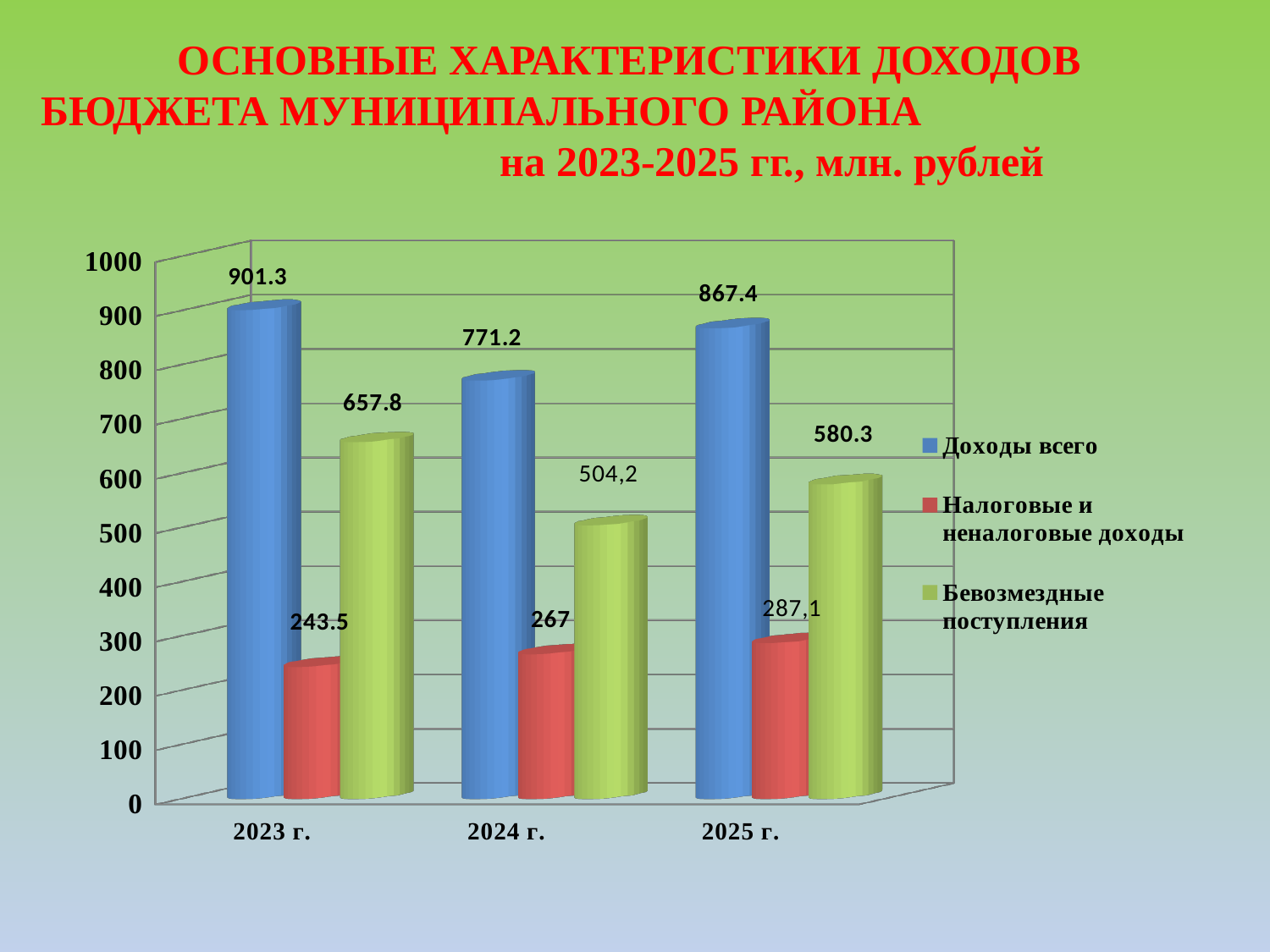
What is the value of Безвозмездные поступления for 2024 г.? 504,2 What is the difference between Доходы всего in 2023 г. and in 2024 г.? 130.1 What is the value of Налоговые и неналоговые доходы for 2025 г.? 287,1 In which year is Доходы всего the highest? 2023 г. In which year is Налоговые и неналоговые доходы the lowest? 2023 г. How many years are shown on the x axis? 3 What kind of chart is shown on the slide? Bar chart What is the value of Доходы всего for 2023 г.? 901.3 Do the values of Налоговые и неналоговые доходы rise or fall from 2023 г. to 2025 г.? Rise What is the difference between Безвозмездные поступления in 2023 г. and in 2025 г.? 77.5 Which is larger: Безвозмездные поступления in 2024 г. or in 2025 г.? 2025 г. How many series does the legend list? 3